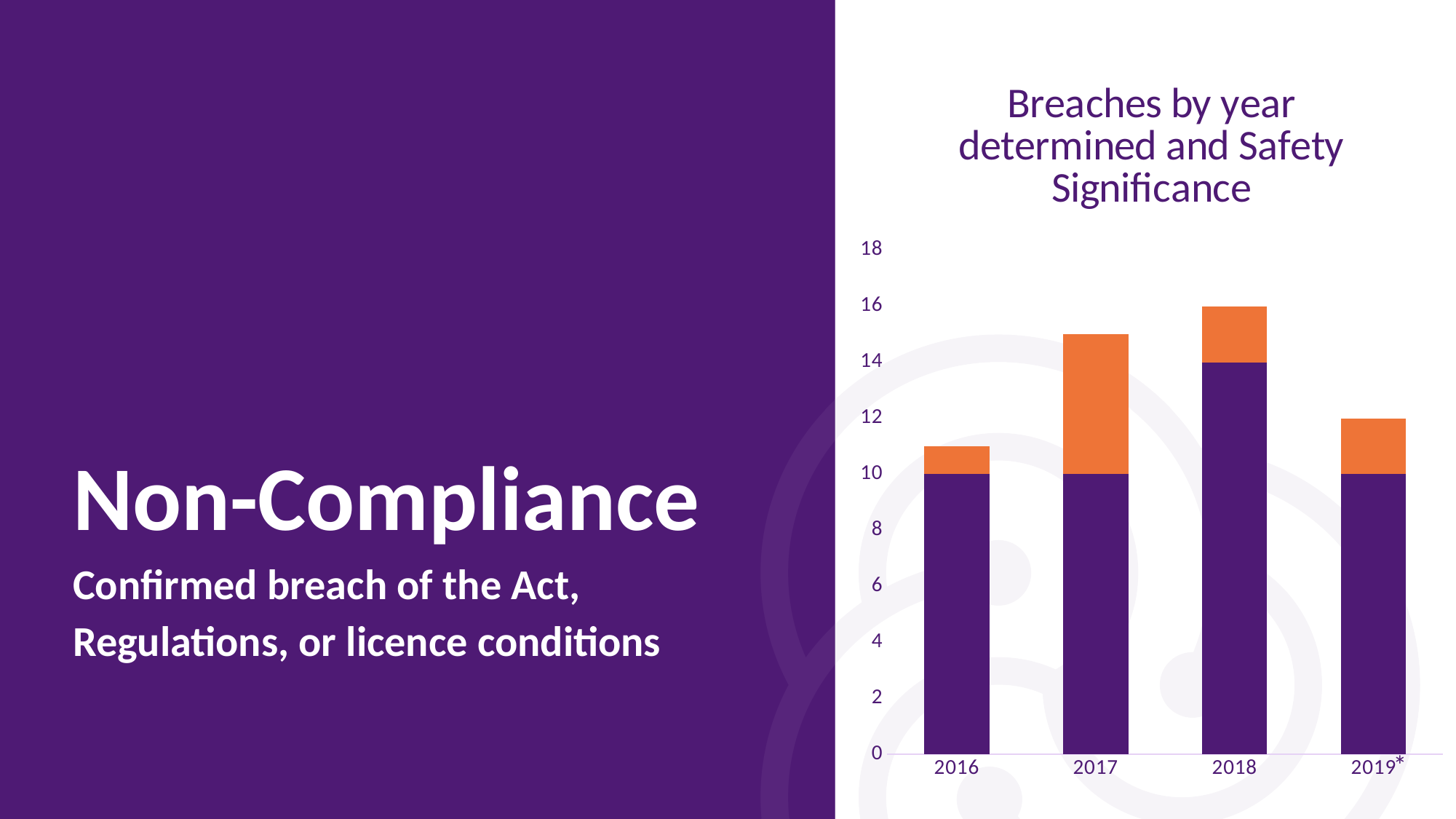
Is the total value for 2017 greater or less than 14? greater What is the total height of the bar for 2018? 16 What is the total height of the bar for 2019*? 12 Is the total value for 2016 greater or less than 12? less Which year has the tallest bar in the chart? 2018 How many years are shown on the x axis of the chart? 4 Which year has a larger total bar, 2017 or 2019*? 2017 Which year has the shortest bar in the chart? 2016 What kind of chart is shown on the slide? Stacked bar chart What is the height of the purple segment for 2016? 10 What is the title of the chart? Breaches by year determined and Safety Significance What is the height of the purple segment for 2018? 14